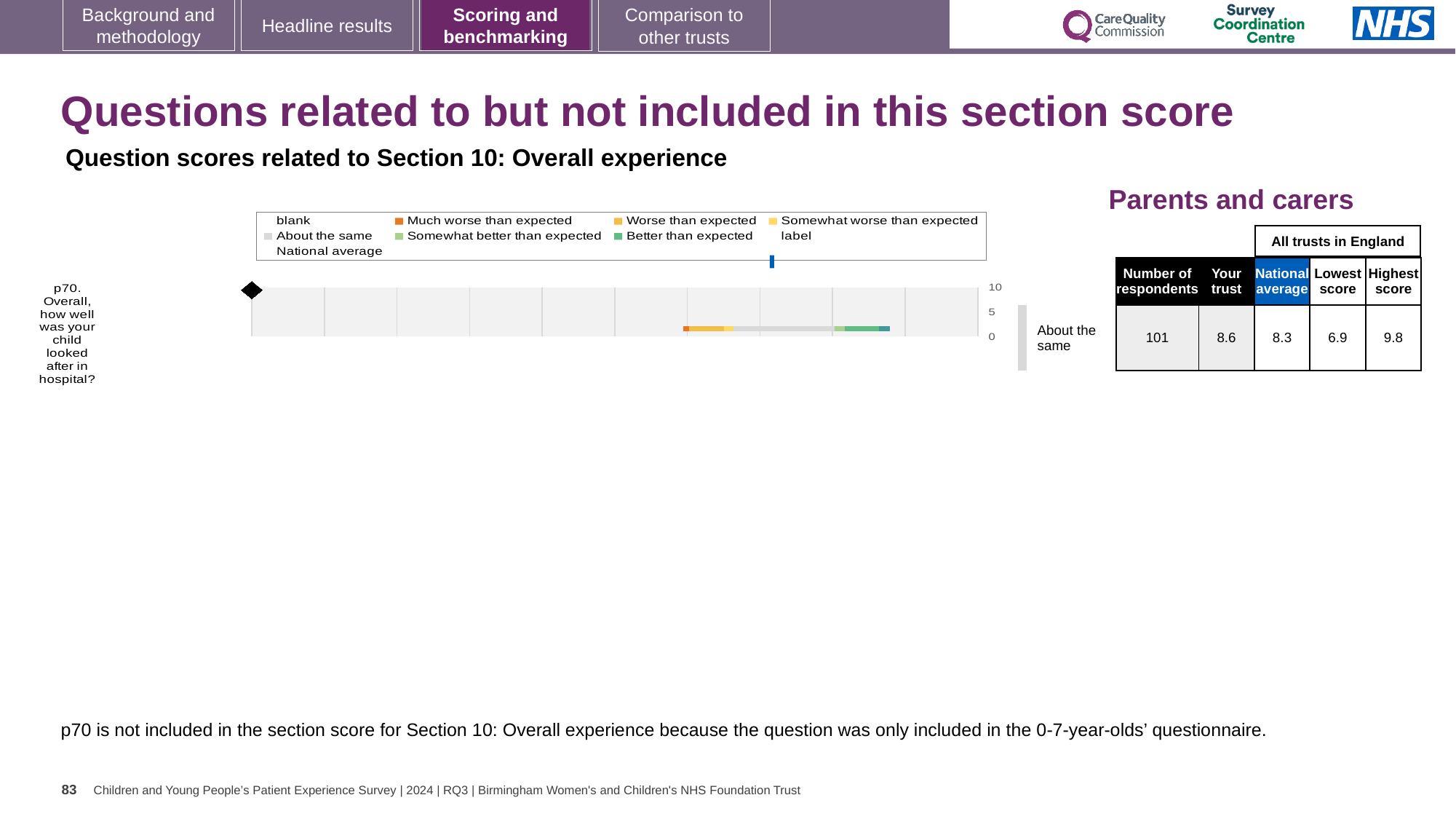
For p70, which is higher: the 'Your trust' score or the national average? Your trust What kind of chart is used to show the p70 question score? bar chart Which benchmarking category is the trust's result for p70 labelled as, to the right of the chart? About the same In the table beside the chart, what is the highest score among all trusts in England for p70? 9.8 How many respondents answered question p70, according to the table beside the chart? 101 For p70, what is the difference between the 'Your trust' score and the national average? 0.3 For p70, what is the difference between the highest score and the lowest score among all trusts in England? 2.9 In the table beside the chart, what is the national average score for p70? 8.3 In the table beside the chart, what is the 'Your trust' score for p70? 8.6 In the table beside the chart, what is the lowest score among all trusts in England for p70? 6.9 How many survey questions are plotted in the chart? 1 What is the full text of the question plotted in the chart? p70. Overall, how well was your child looked after in hospital?